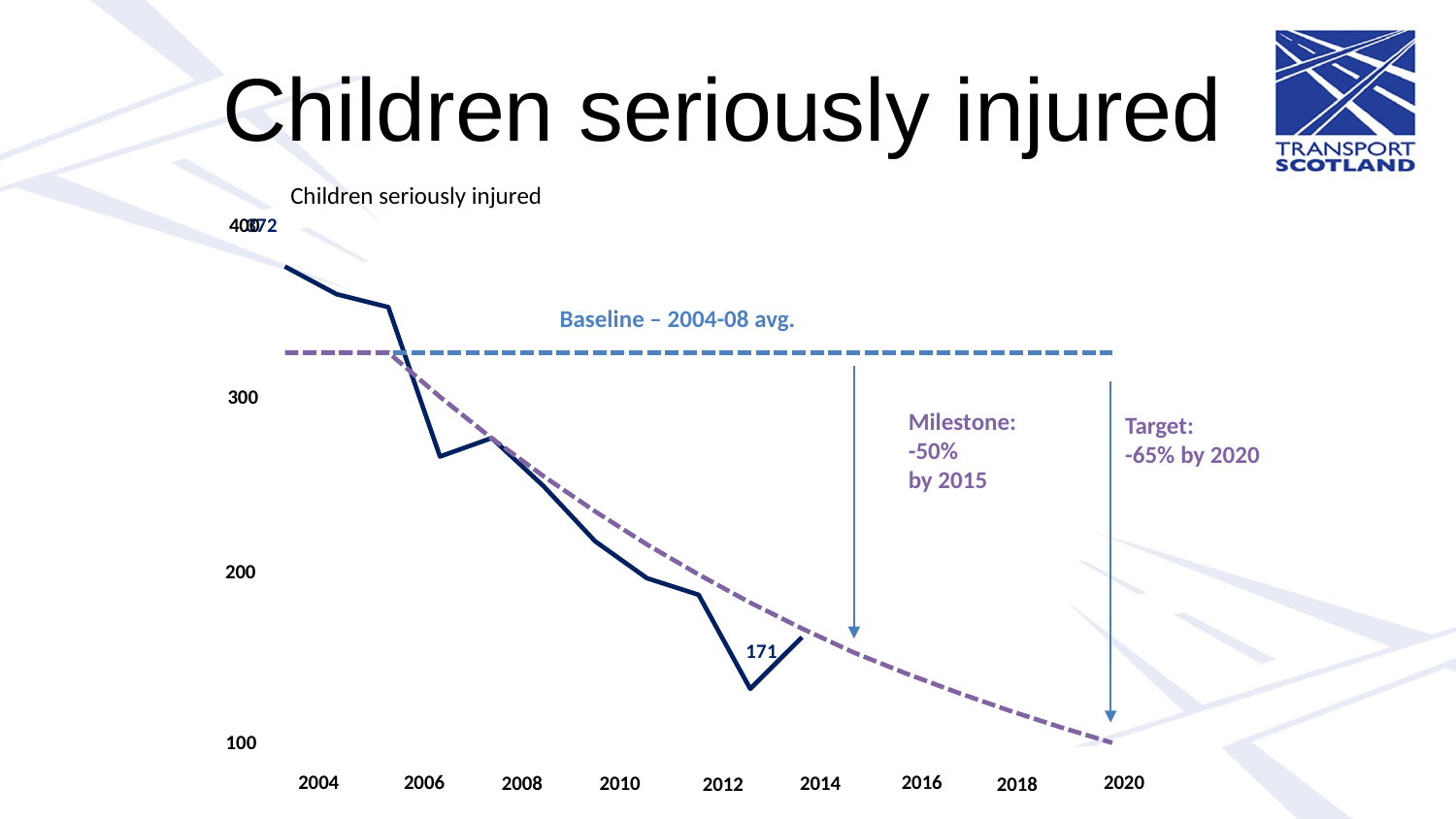
Is the value for 2013 greater or less than 200? less Is the value for 2010 greater or less than 200? greater In which year is the solid line at its highest? 2004 Is the value for 2004 greater or less than 300? greater What does the horizontal dashed line represent, according to its label? Baseline – 2004-08 avg. What kind of chart is shown on the slide? line chart In which year does the solid line reach its lowest point? 2013 What value is printed as a data label on the solid line near its lowest point? 171 How many year labels are shown on the x axis? 9 Does the solid line for children seriously injured generally rise or fall from 2004 to 2013? fall What is the title of the chart? Children seriously injured